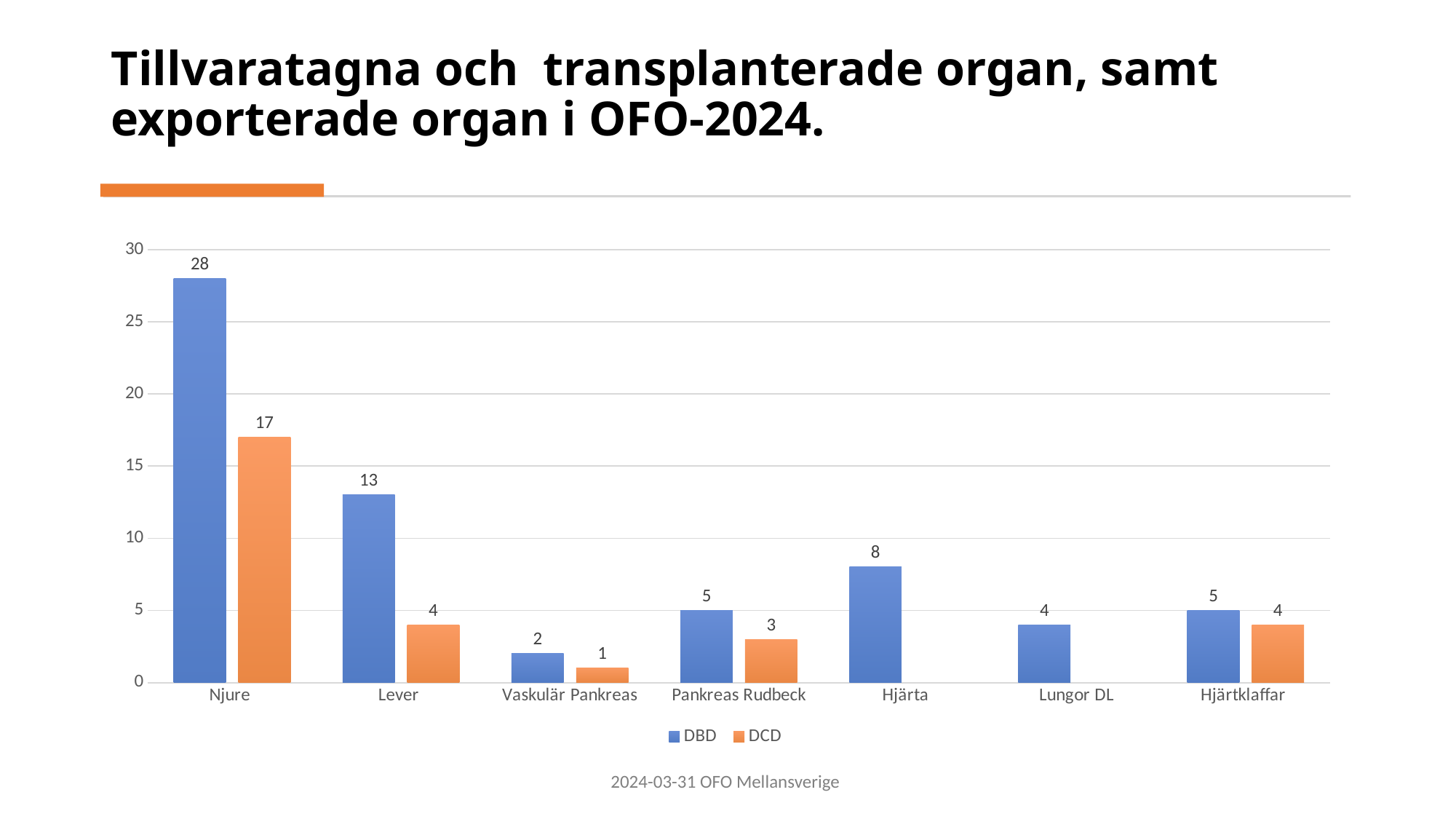
What is the DBD value for Hjärta? 8 Which colour represents the DCD series? Orange Which is larger for Lever, the DBD value or the DCD value? DBD What is the DCD value for Lever? 4 Which category has the lowest DCD value among those with a DCD bar? Vaskulär Pankreas What is the DCD value for Pankreas Rudbeck? 3 How many series does the legend list? 2 How many categories are shown on the x axis? 7 What is the difference between the DBD and DCD values for Njure? 11 What is the DBD value for Njure? 28 Which category has the highest DBD value? Njure What kind of chart is shown on the slide? Bar chart